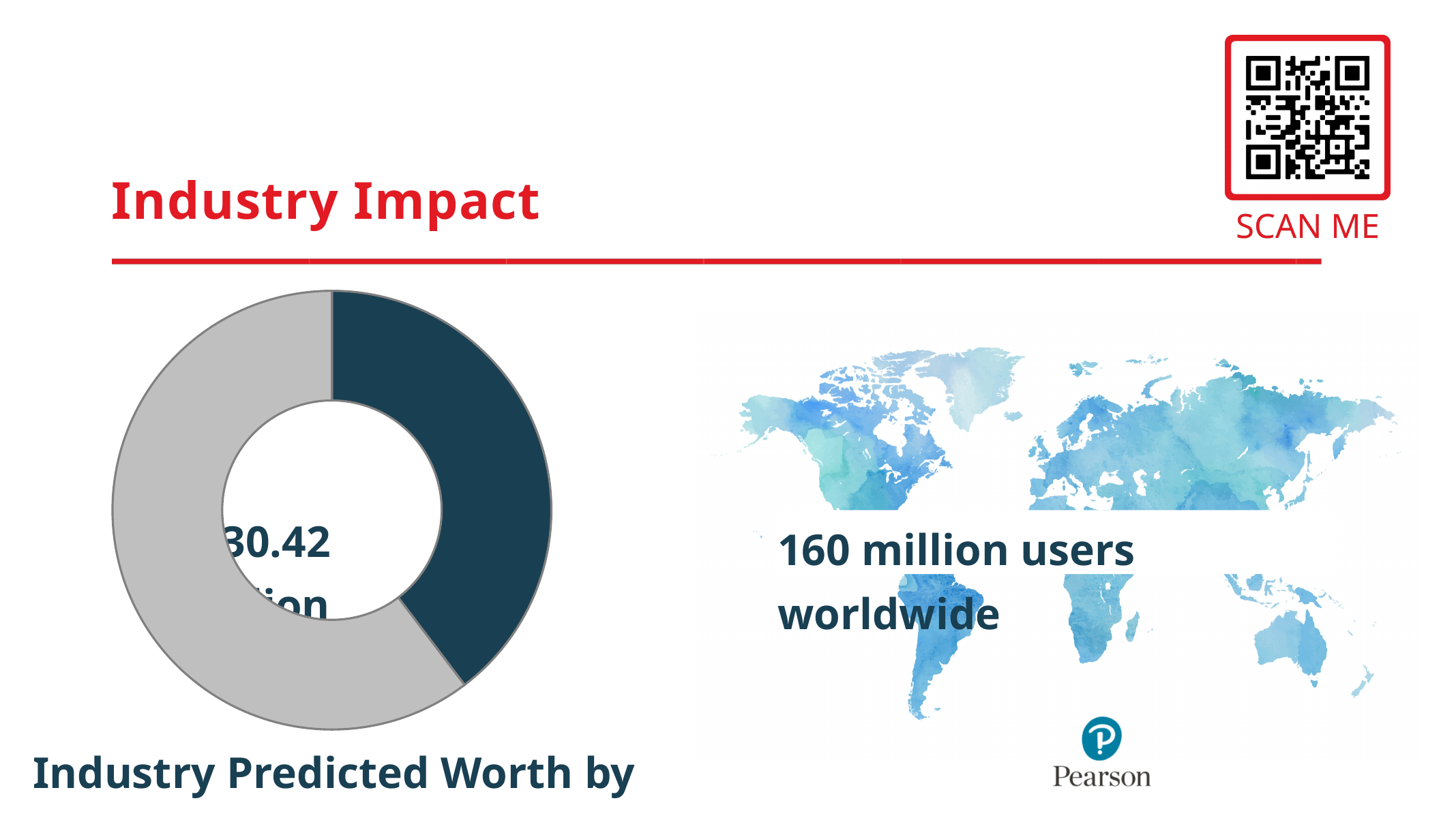
Does the dark blue slice of the doughnut chart on the left cover more or less than half of the ring? Less What kind of chart is shown on the left of the slide? Doughnut (pie) chart Does the doughnut chart on the left have a legend? No What two colours are used for the slices of the doughnut chart on the left? Dark blue and grey In the doughnut chart on the left, which slice is the smallest? The dark blue slice Does the grey slice of the doughnut chart on the left cover more or less than half of the ring? More In the doughnut chart on the left, which slice is the largest? The grey slice How many slices does the doughnut chart on the left have? 2 In the doughnut chart on the left, which slice is larger, the grey one or the dark blue one? The grey one